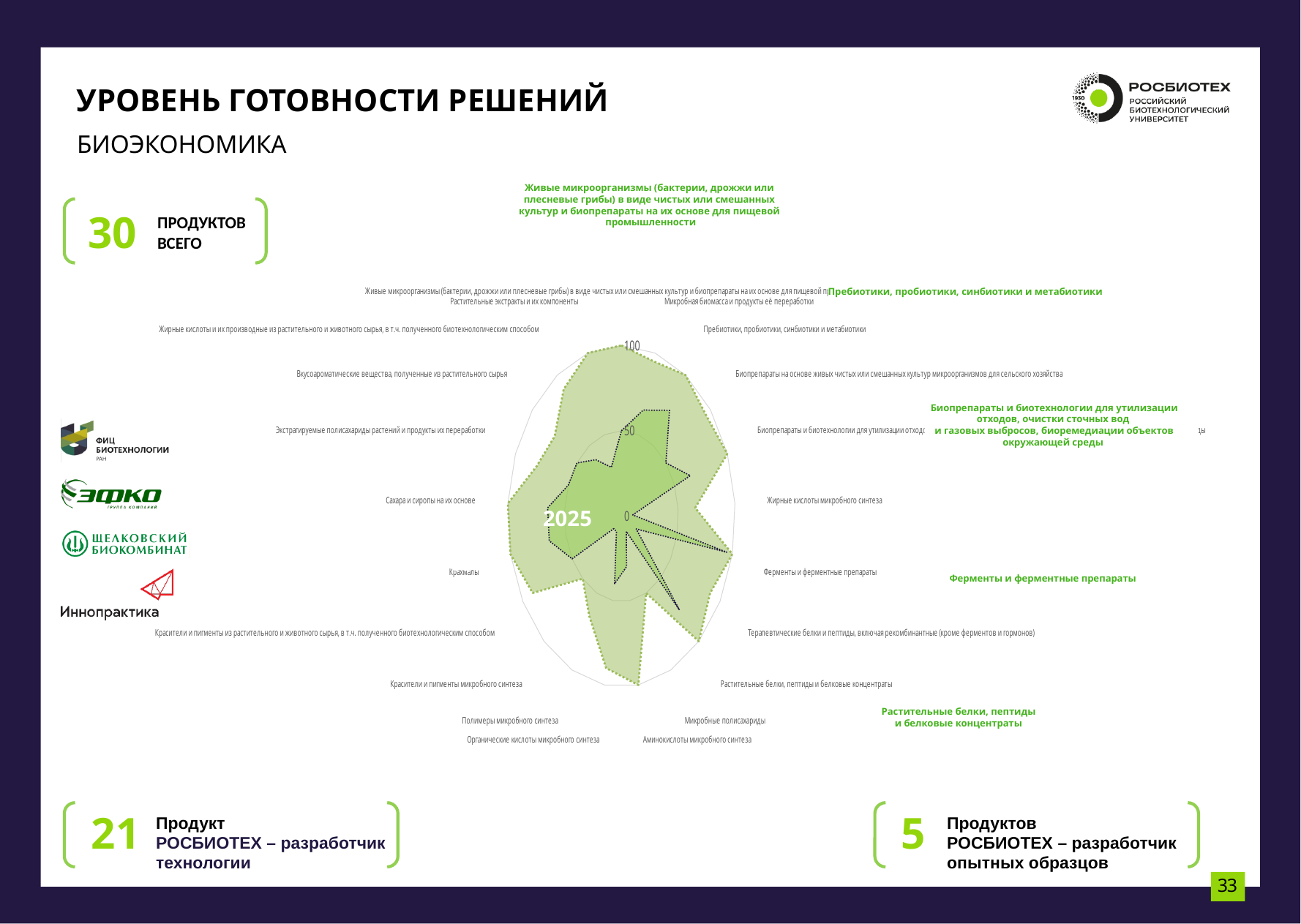
Is the value of the outer filled series for 'Живые микроорганизмы (бактерии, дрожжи или плесневые грибы)... для пищевой промышленности' greater or less than 50? greater What kind of chart is shown on the slide? radar chart How many series are plotted on the radar chart? 2 What is the highest value marked on the chart's axis scale? 100 Is the value of the inner dotted series for 'Микробные полисахариды' greater or less than 50? less What year label is printed inside the radar chart? 2025 How many categories (axes) does the radar chart have? 21